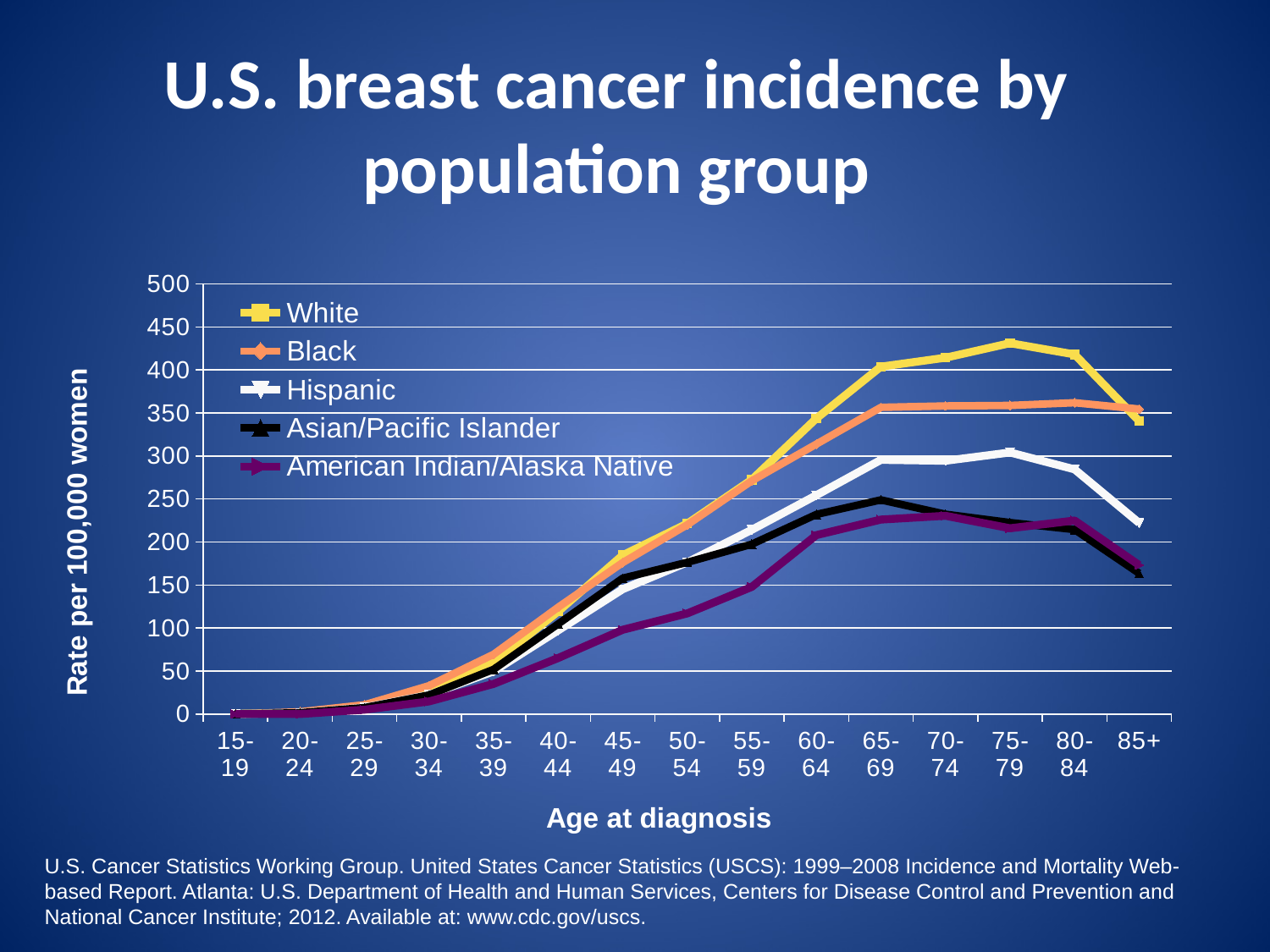
Is the value for White at age 75-79 greater or less than 400? greater How many age groups are shown on the x axis? 15 Which population group has the highest incidence rate at age 75-79? White Is the value for American Indian/Alaska Native at age 50-54 greater or less than 150? less In which age group does the White series reach its highest value? 75-79 At age 60-64, which is larger: the value for Black or the value for Hispanic? Black Does the White series rise or fall from age 15-19 to age 75-79? rise Which population group has the lowest incidence rate at age 55-59? American Indian/Alaska Native Is the value for Asian/Pacific Islander at age 65-69 greater or less than 200? greater How many series does the legend list? 5 What kind of chart is shown on the slide? line chart